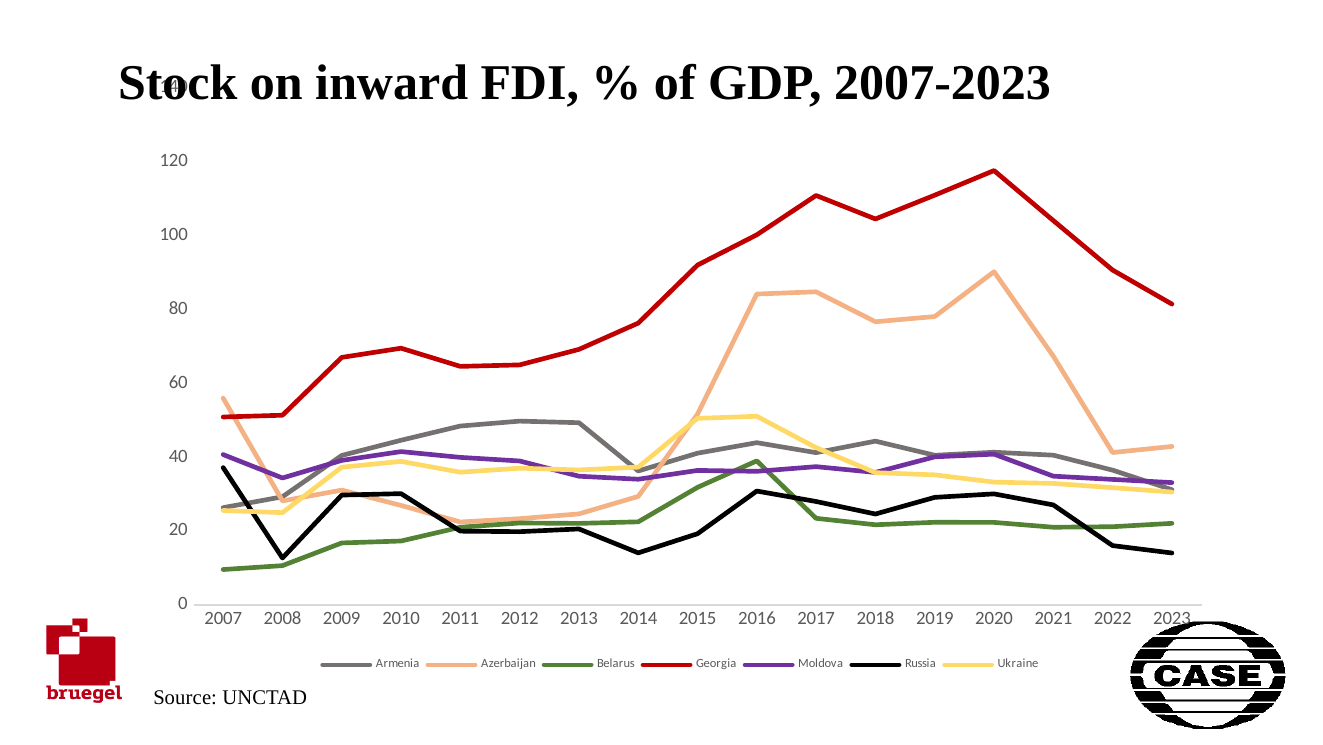
How many years are plotted along the x axis? 17 Is the value for Belarus in 2007 greater or less than 20? less Which country has the lowest value in 2023? Russia How many countries (series) does the legend list? 7 Is the value for Georgia in 2020 greater or less than 100? greater Is the value for Azerbaijan in 2020 greater or less than 80? greater Which country has the lowest value in 2007? Belarus Which country has the highest stock of inward FDI as % of GDP in 2023? Georgia In which year does Georgia reach its highest value? 2020 In 2016, which is larger: the value for Georgia or the value for Azerbaijan? Georgia What kind of chart is shown on the slide? line chart Does the value for Georgia rise or fall from 2020 to 2023? fall